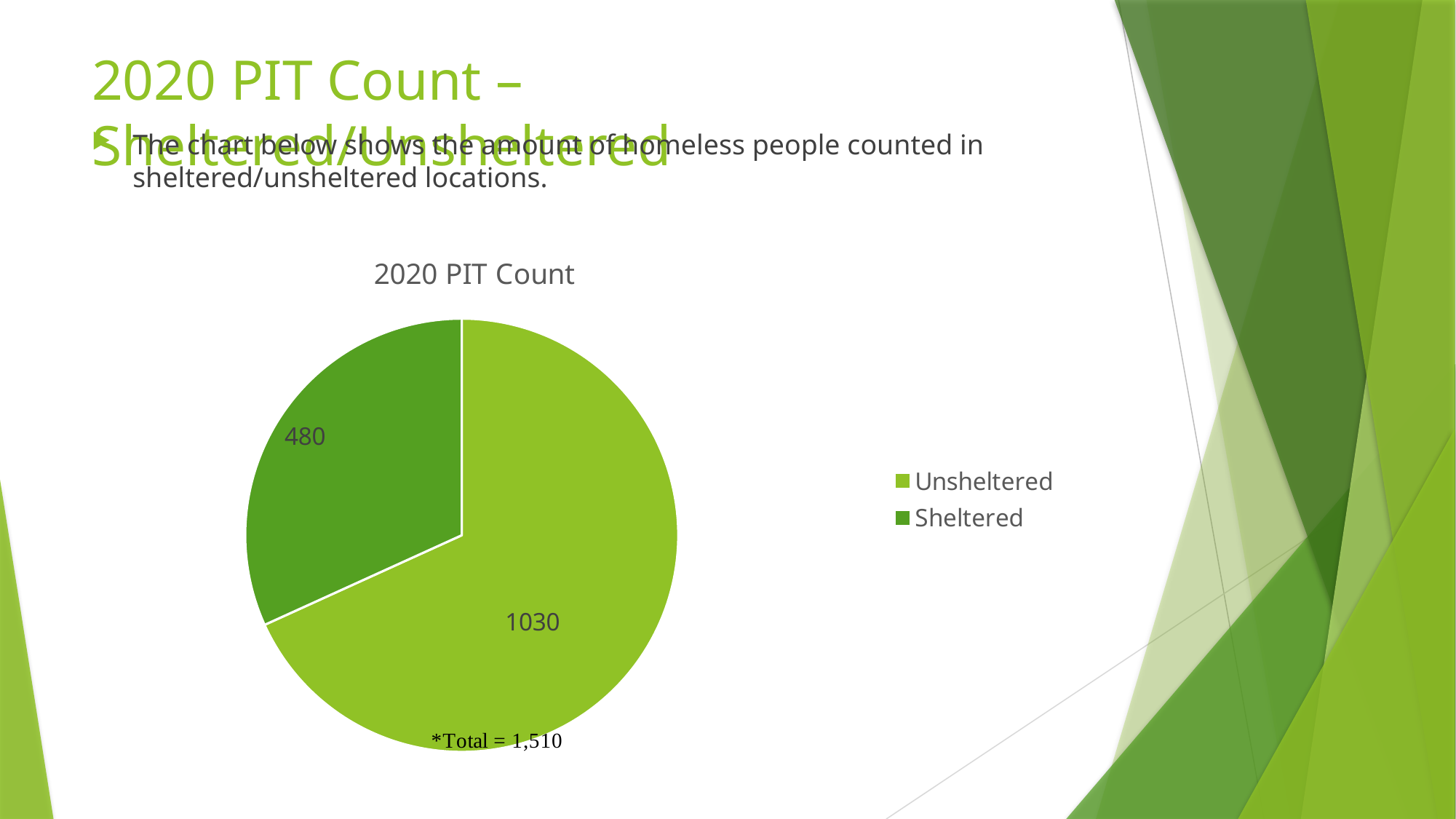
Which category has the largest slice in the pie chart? Unsheltered What is the value for Sheltered in the 2020 PIT Count pie chart? 480 Which legend entry is shown in the darker green colour? Sheltered How many entries does the legend list? 2 What is the title of the chart? 2020 PIT Count What is the difference between the Unsheltered and Sheltered values? 550 How many slices does the pie chart have? 2 What total is printed below the pie chart? 1,510 What type of chart is shown on the slide? pie chart Which category has the smallest slice in the pie chart? Sheltered What is the value for Unsheltered in the 2020 PIT Count pie chart? 1030 Which is larger, the Sheltered value or the Unsheltered value? Unsheltered